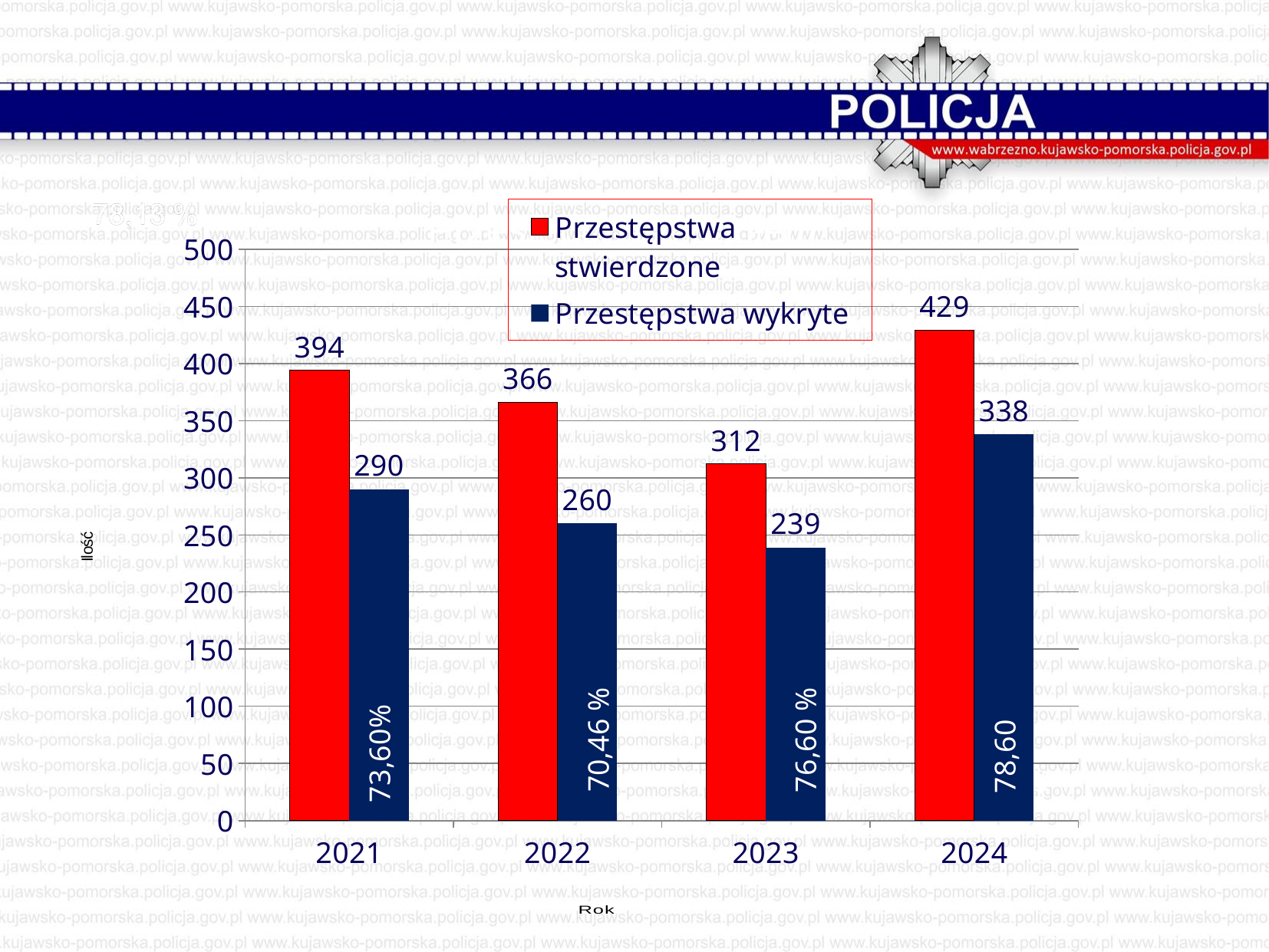
How many years are shown on the x axis? 4 In which year is Przestępstwa wykryte lowest? 2023 What is the value of Przestępstwa wykryte for 2023? 239 How many series does the legend list? 2 What is the value of Przestępstwa wykryte for 2024? 338 What is the value of Przestępstwa stwierdzone for 2021? 394 What percentage label is printed inside the Przestępstwa wykryte bar for 2021? 73,60% What kind of chart is shown on the slide? Bar chart Which is larger: Przestępstwa stwierdzone in 2023 or Przestępstwa wykryte in 2024? Przestępstwa wykryte in 2024 In which year is Przestępstwa stwierdzone highest? 2024 What is the difference between Przestępstwa stwierdzone and Przestępstwa wykryte in 2022? 106 What colour are the Przestępstwa stwierdzone bars? Red